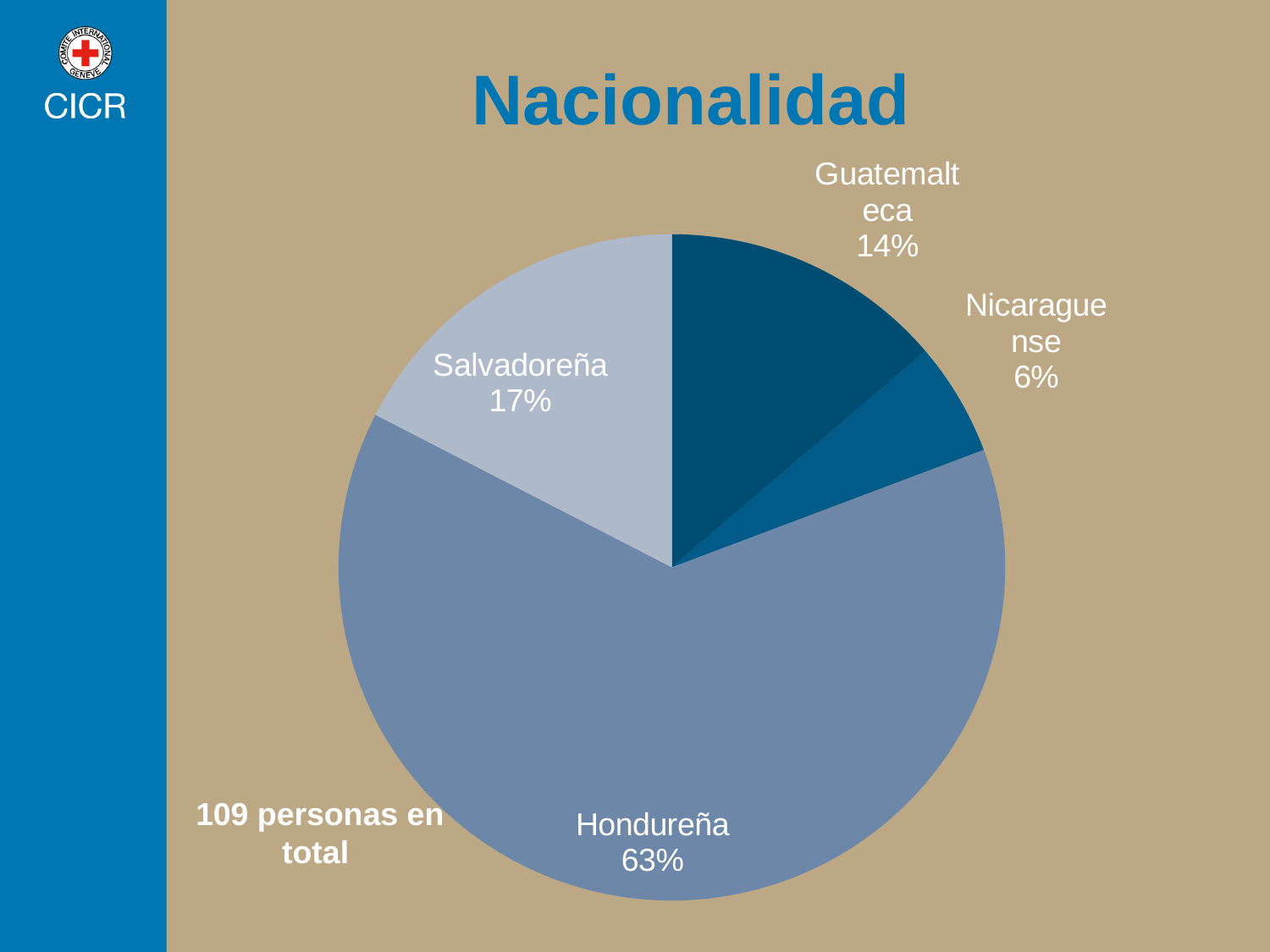
What is the difference in percentage points between the Guatemalteca and Nicaraguense slices? 8 What kind of chart is shown on the slide? Pie chart How many slices does the pie chart have? 4 Which nationality has the largest share of the pie? Hondureña What percentage is shown for the Nicaraguense slice? 6% What is the difference in percentage points between the Hondureña and Salvadoreña slices? 46 What percentage of the pie does the Hondureña slice represent? 63% What is the title of the chart? Nacionalidad Which nationality has the smallest share of the pie? Nicaraguense What percentage is shown for the Salvadoreña slice? 17% What percentage is shown for the Guatemalteca slice? 14% Which slice is larger, Salvadoreña or Guatemalteca? Salvadoreña